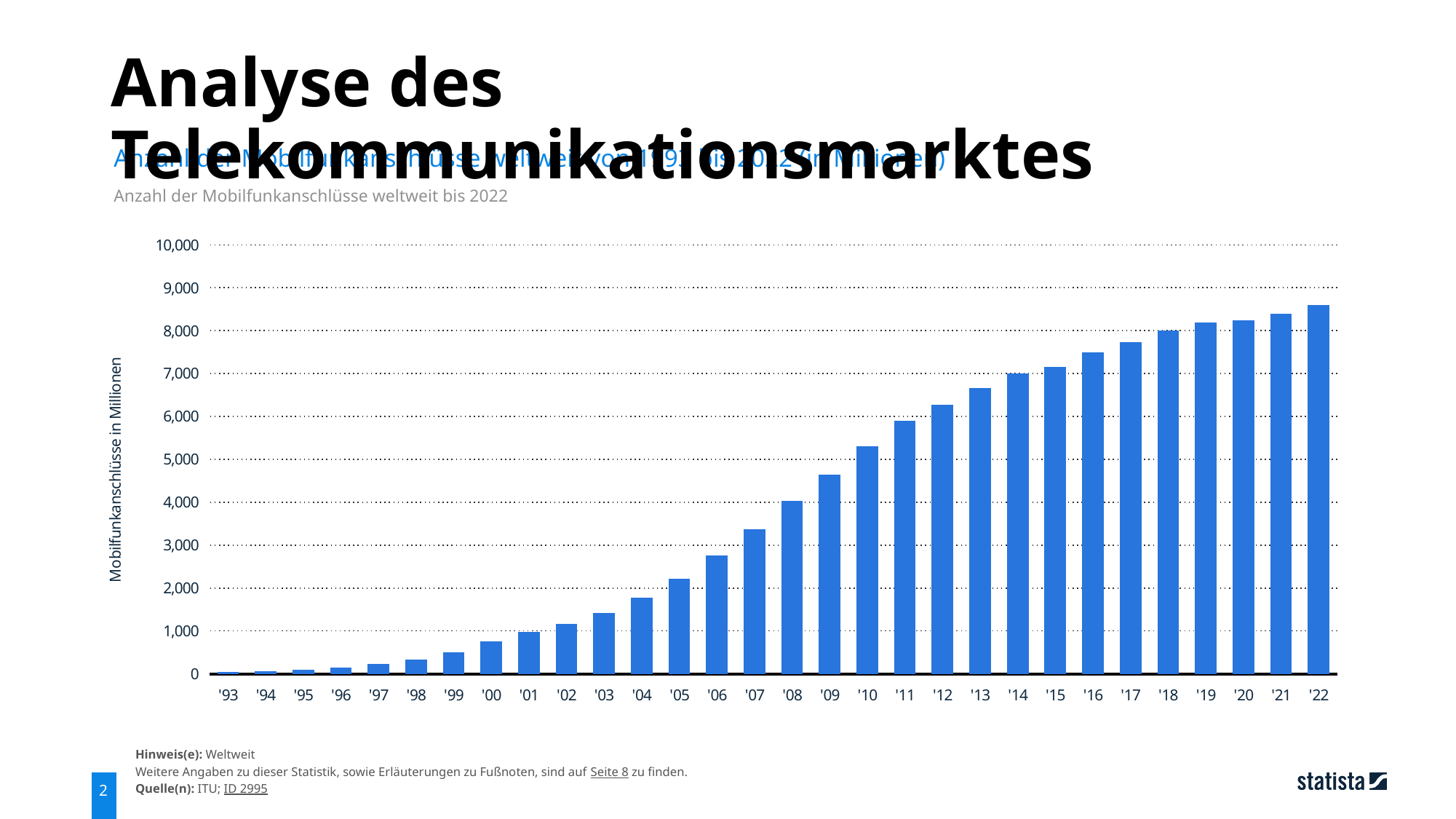
Is the value for '22 greater or less than 8,000? greater Is the value for '93 greater or less than 1,000? less Is the value for '10 greater or less than 5,000? greater What is the subtitle shown above the chart? Anzahl der Mobilfunkanschlüsse weltweit bis 2022 Which is larger, the value for '05 or the value for '10? '10 What is the label of the vertical axis? Mobilfunkanschlüsse in Millionen How many years (bars) are plotted on the chart? 30 What kind of chart is shown on the slide? bar chart Do the values rise or fall from '93 to '22? rise Which year has the lowest number of mobile subscriptions? '93 Which year has the highest number of mobile subscriptions? '22